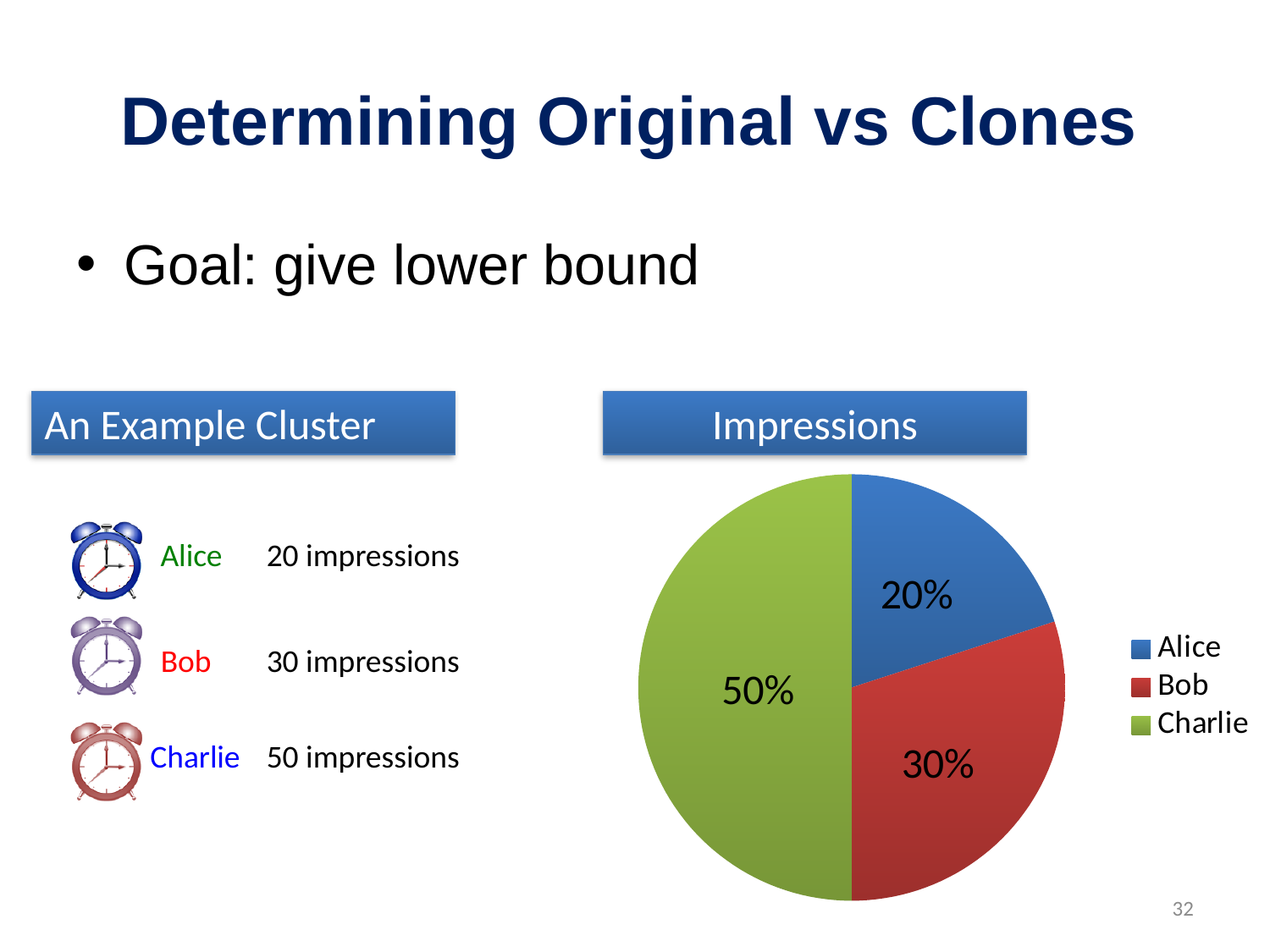
What kind of chart is shown under the title "Impressions"? pie chart What is the difference in percentage points between Charlie's share and Bob's share? 20% What share of the pie does Bob have? 30% Which slice of the pie chart is the largest? Charlie How many slices does the pie chart have? 3 What share of the pie does Alice have? 20% What share of the pie does Charlie have? 50% Which slice of the pie chart is the smallest? Alice Which is larger in the pie chart, Bob's share or Alice's share? Bob What colour is the slice for Charlie in the pie chart? green How many entries does the legend of the pie chart list? 3 What is the title of the pie chart? Impressions